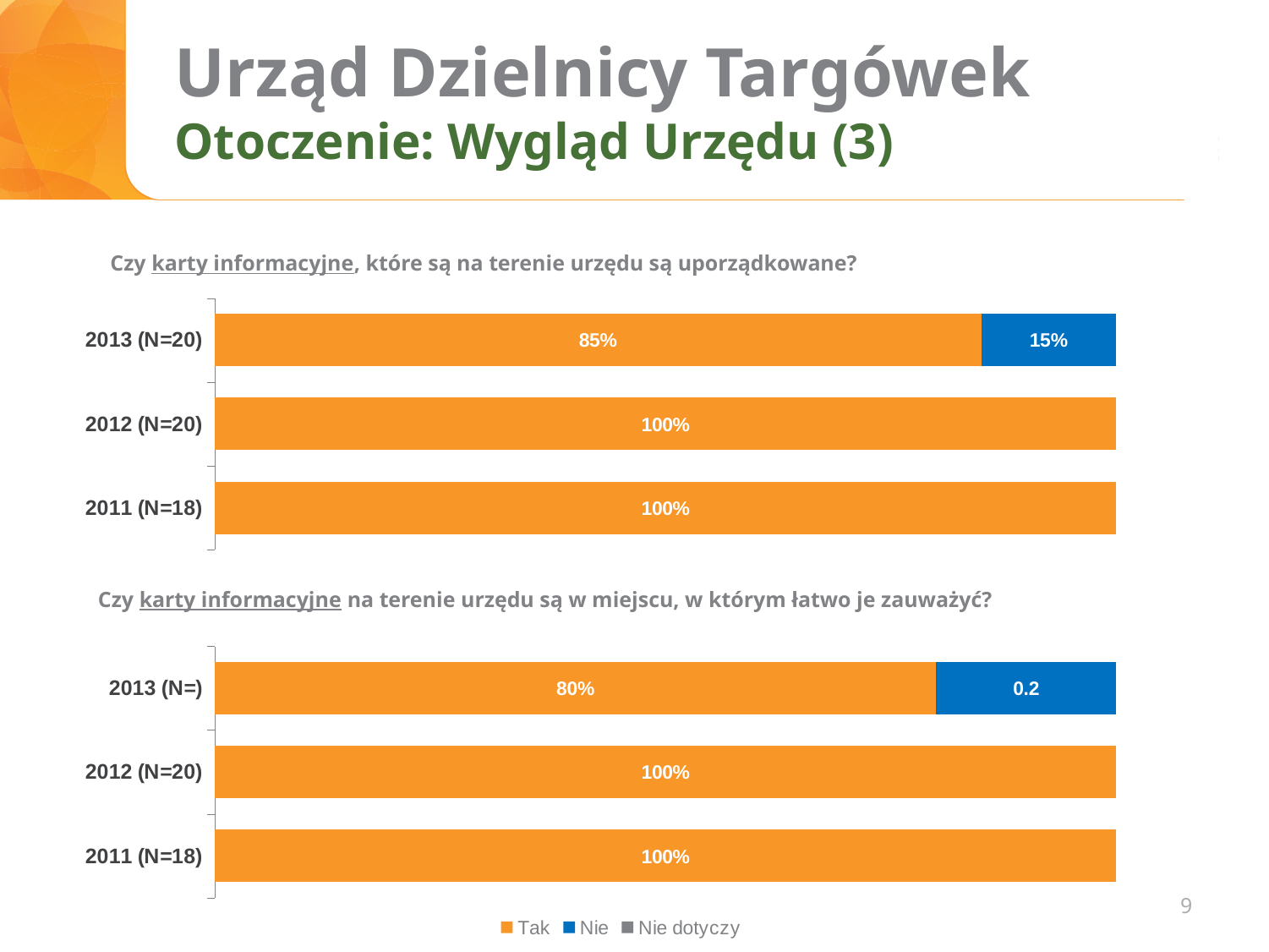
In the top chart, which year has the lowest "Tak" value? 2013 (N=20) How many series does the legend at the bottom of the slide list? 3 How many categories (years) are shown in the top chart? 3 In the bottom chart, what is the value for "Tak" in 2013 (N=)? 80% In the top chart, what is the value for "Tak" in 2013 (N=20)? 85% In the top chart, what is the difference between the "Tak" value in 2012 (N=20) and the "Tak" value in 2013 (N=20)? 15% In the top chart, what is the value for "Nie" in 2013 (N=20)? 15% In the top chart, what is the value for "Tak" in 2012 (N=20)? 100% In the bottom chart, what is the value for "Tak" in 2011 (N=18)? 100% In the bottom chart, what label is printed on the "Nie" segment for 2013 (N=)? 0.2 What type of chart is the bottom chart? Bar chart In the bottom chart, which is larger: the "Tak" value for 2013 (N=) or the "Tak" value for 2012 (N=20)? 2012 (N=20)